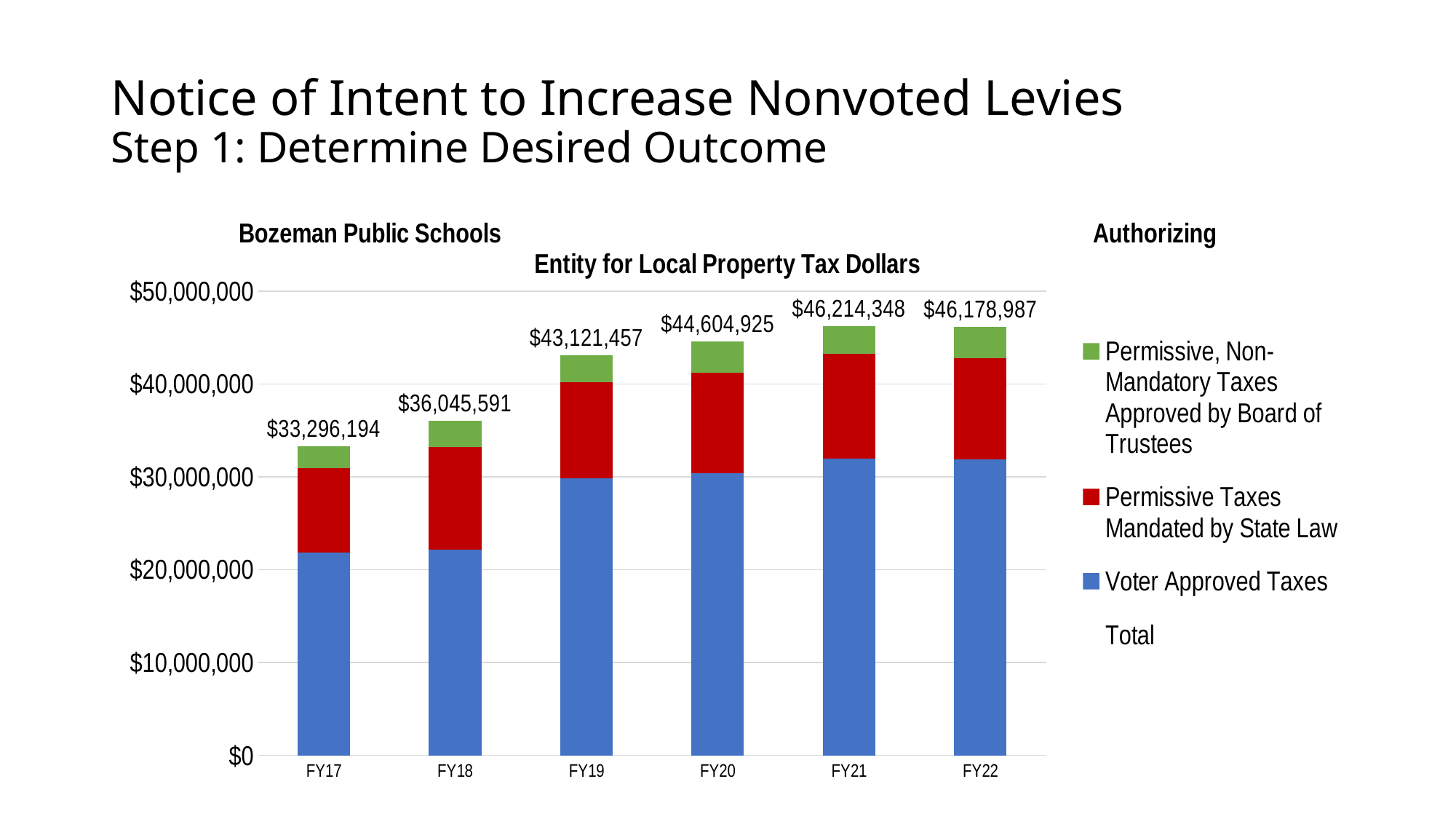
Is the Voter Approved Taxes value for FY17 greater or less than $20,000,000? greater What is the total for FY22? $46,178,987 Do the totals rise or fall from FY17 to FY21? rise What is the total for FY20? $44,604,925 What is the difference between the FY18 total and the FY17 total? $2,749,397 How many fiscal years are shown on the x axis? 6 Which fiscal year has the highest total? FY21 Which is larger, the total for FY19 or the total for FY20? FY20 Which fiscal year has the lowest total? FY17 What type of chart is shown on the slide? Stacked bar chart What is the total for FY17? $33,296,194 What is the difference between the FY21 total and the FY22 total? $35,361